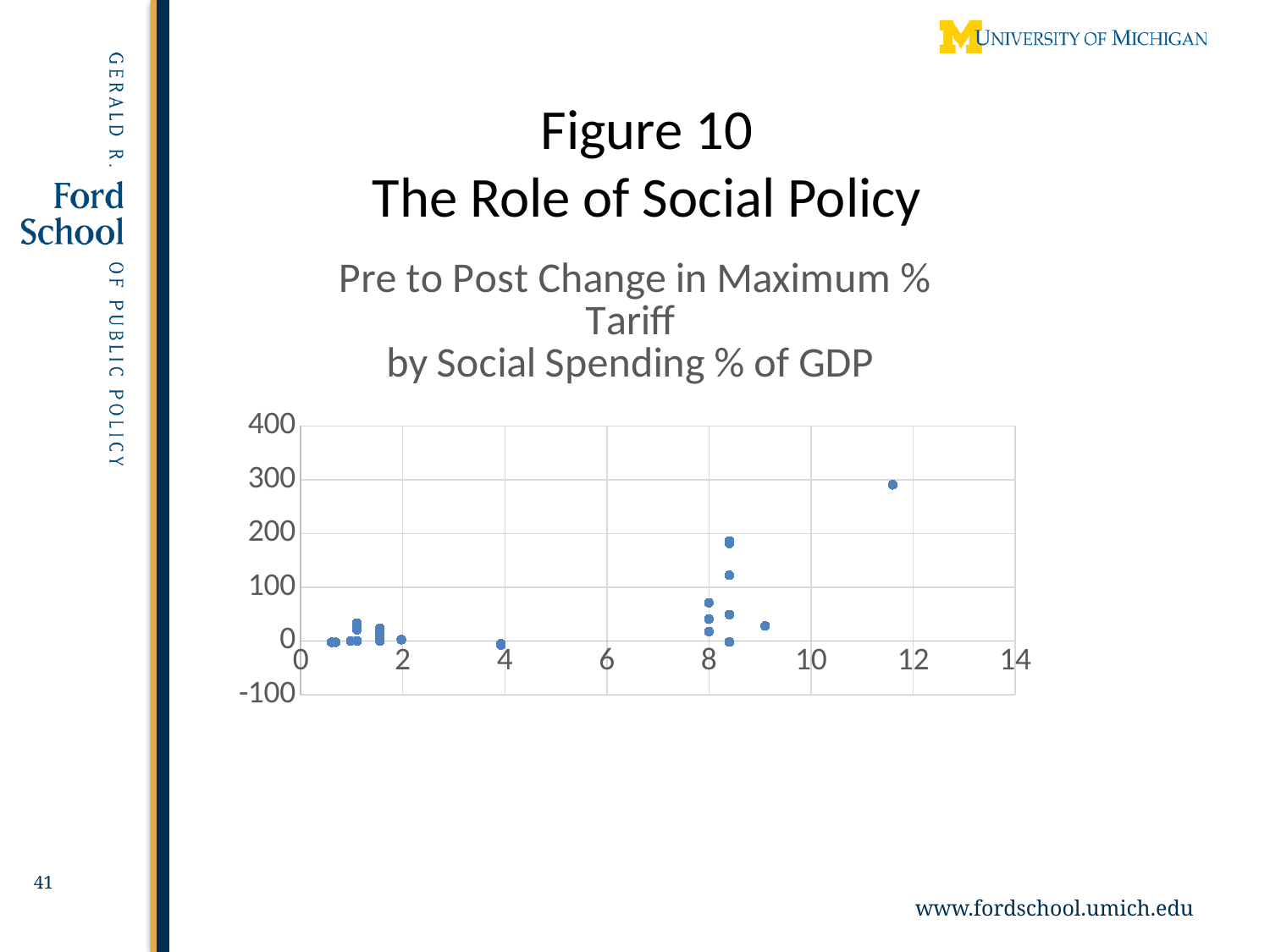
Is the horizontal value of the rightmost plotted point greater or less than 10? greater Do the plotted values generally rise or fall as the horizontal axis value increases? rise What kind of chart is shown on the slide? scatter chart Are the vertical values of the points plotted below 2 on the horizontal axis greater or less than 100? less Is the vertical value of the highest plotted point greater or less than 200? greater What is the title of the chart? Pre to Post Change in Maximum % Tariff by Social Spending % of GDP